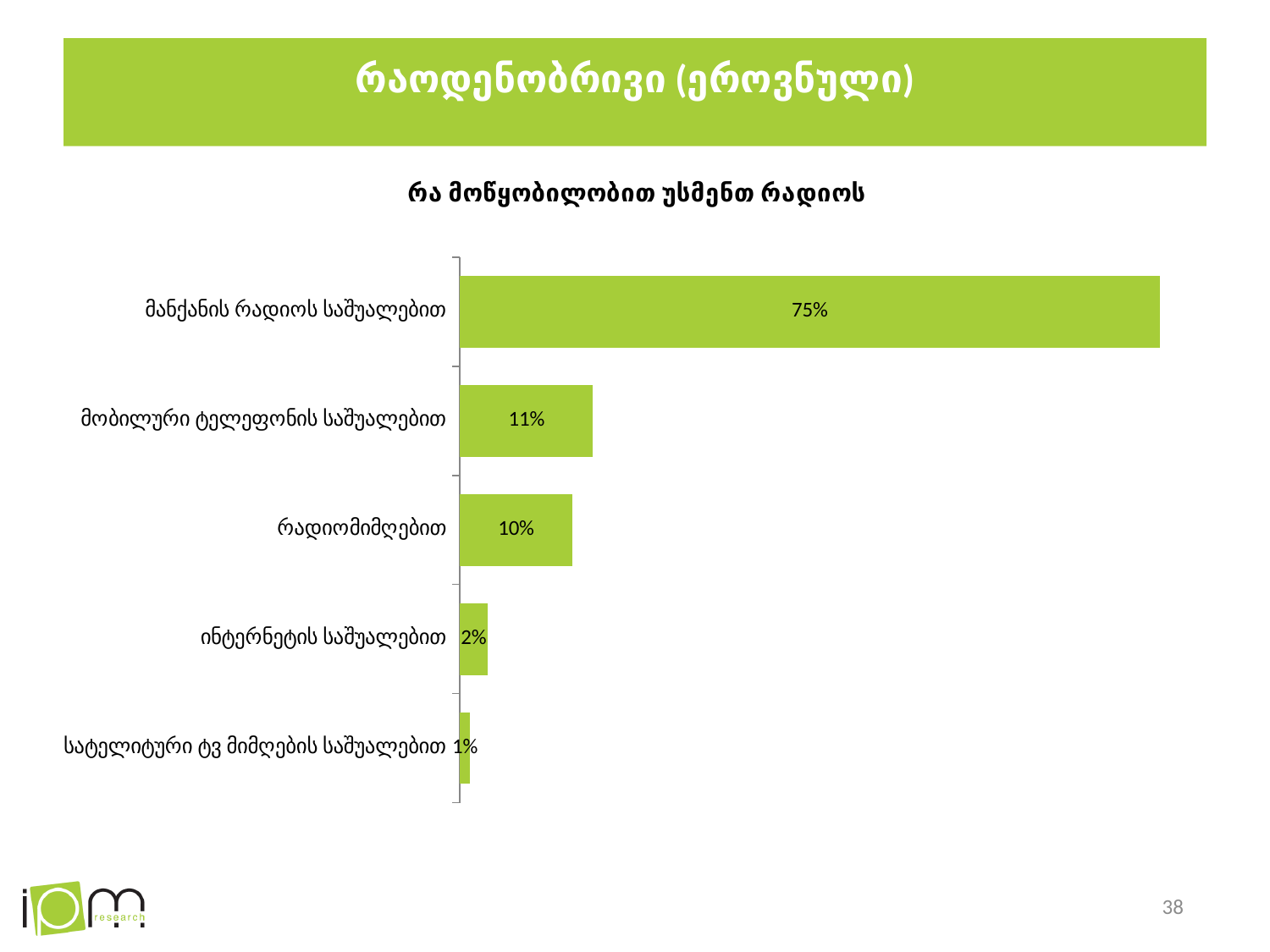
Which is larger: the value for "მობილური ტელეფონის საშუალებით" or for "რადიომიმღებით"? მობილური ტელეფონის საშუალებით What is the title of the chart? რა მოწყობილობით უსმენთ რადიოს What value is shown for "მანქანის რადიოს საშუალებით"? 75% Which category has the highest value? მანქანის რადიოს საშუალებით What value is shown for "სატელიტური ტვ მიმღების საშუალებით"? 1% What value is shown for "მობილური ტელეფონის საშუალებით"? 11% Which category has the lowest value? სატელიტური ტვ მიმღების საშუალებით What is the difference between the values for "მანქანის რადიოს საშუალებით" and "მობილური ტელეფონის საშუალებით"? 64% What kind of chart is shown on the slide? Bar chart How many categories are shown in the chart? 5 What value is shown for "რადიომიმღებით"? 10% What value is shown for "ინტერნეტის საშუალებით"? 2%